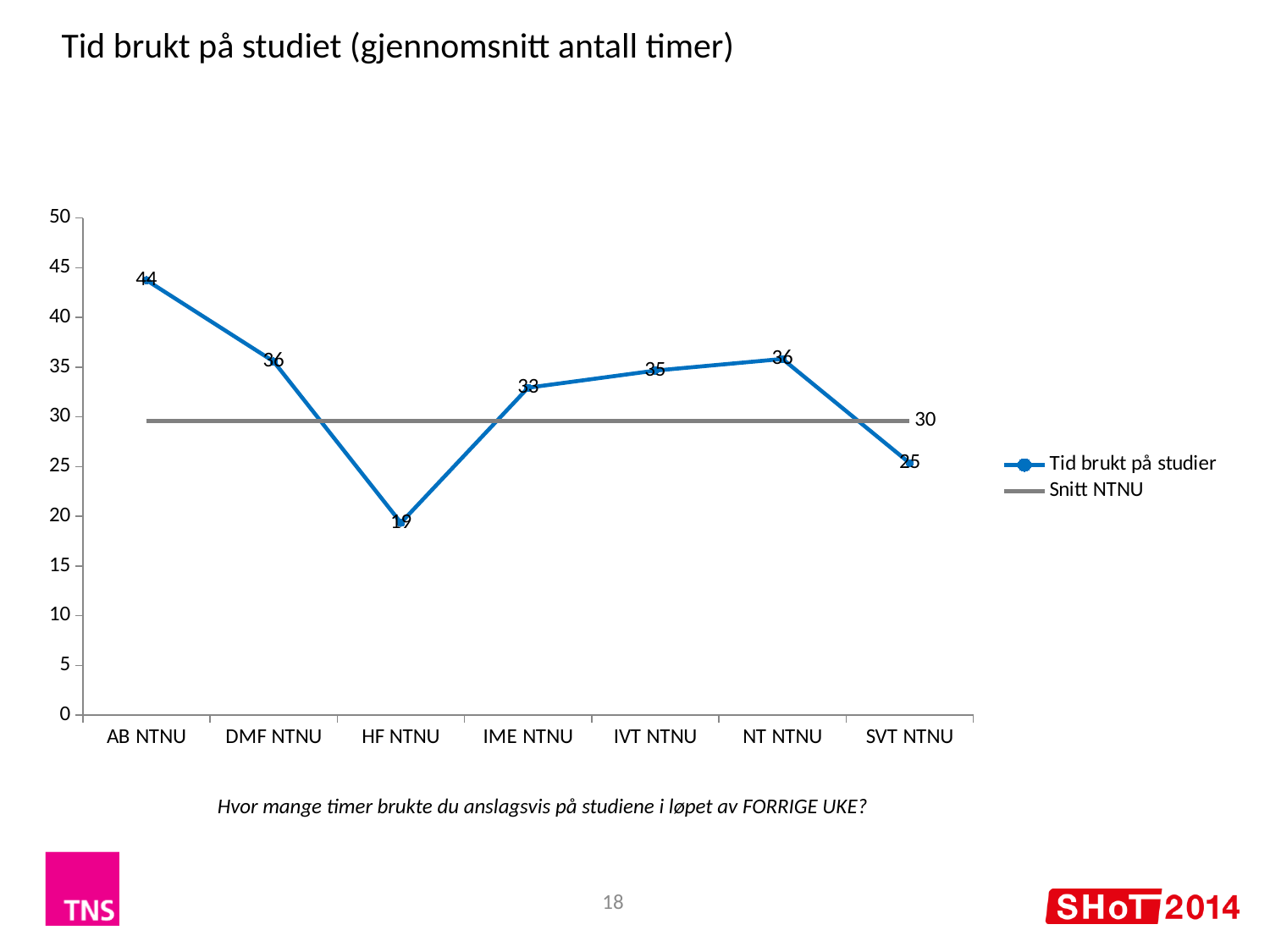
How many categories are shown on the x axis? 7 What is the difference between the values for AB NTNU and HF NTNU? 25 What is the title of the chart? Tid brukt på studiet (gjennomsnitt antall timer) Which is larger, the value for IME NTNU or the value for IVT NTNU? IVT NTNU What is the value for HF NTNU in the 'Tid brukt på studier' series? 19 How many series does the legend list? 2 What is the value for AB NTNU in the 'Tid brukt på studier' series? 44 What kind of chart is shown on the slide? Line chart Which category has the lowest value in the 'Tid brukt på studier' series? HF NTNU What value is shown for the 'Snitt NTNU' line? 30 What is the value for SVT NTNU in the 'Tid brukt på studier' series? 25 Which category has the highest value in the 'Tid brukt på studier' series? AB NTNU